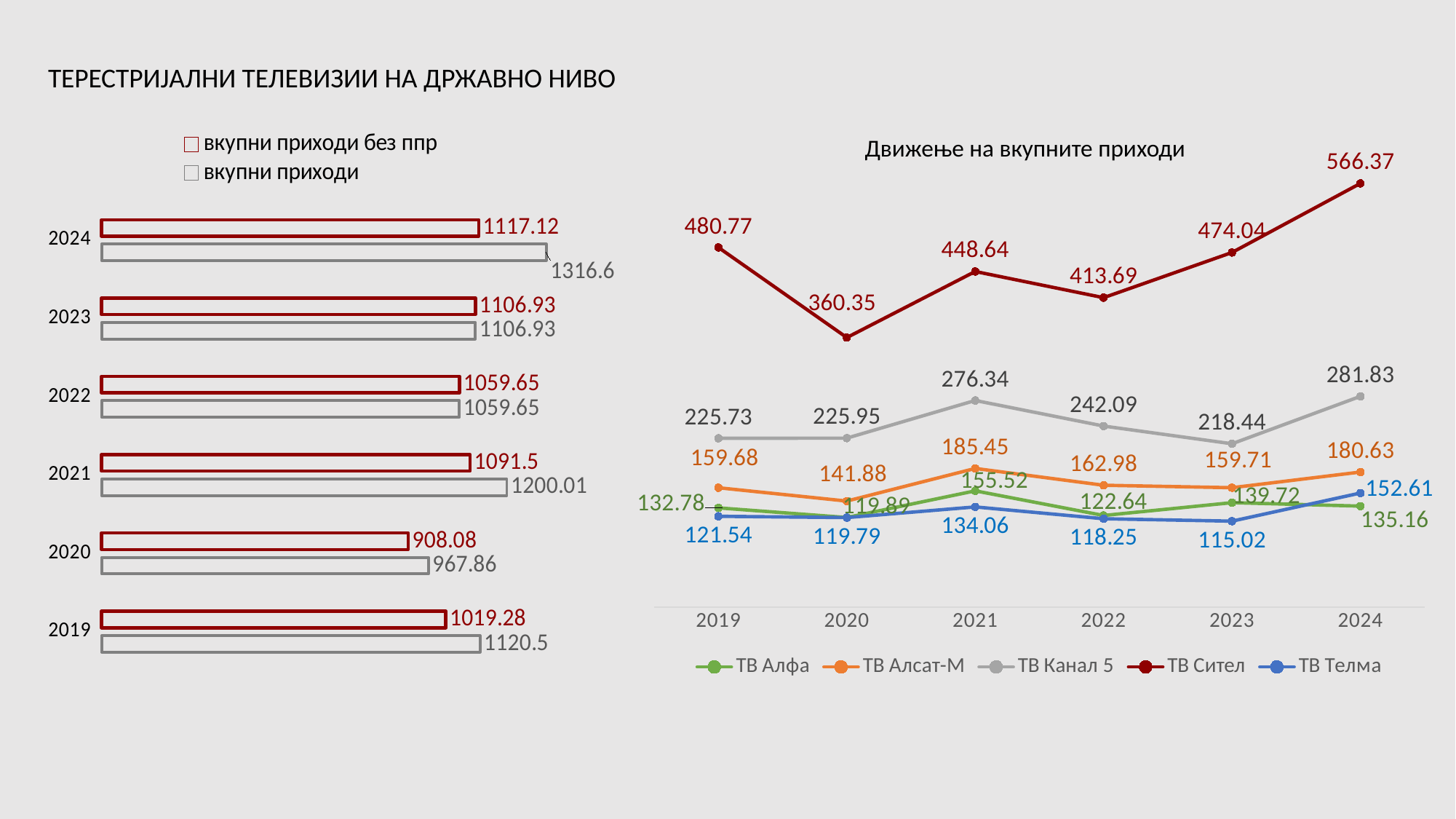
In the chart 'Движење на вкупните приходи', which series has the highest value in 2024? ТВ Сител In the left bar chart, how many series does the legend list? 2 In the left bar chart, which year has the lowest value for 'вкупни приходи'? 2020 In the left bar chart, what is the value of 'вкупни приходи без ппр' for 2020? 908.08 In the left bar chart, what is the difference between 'вкупни приходи' and 'вкупни приходи без ппр' for 2021? 108.51 In the chart 'Движење на вкупните приходи', how many years are shown on the x axis? 6 In the chart 'Движење на вкупните приходи', what is the value for ТВ Сител in 2020? 360.35 In the chart 'Движење на вкупните приходи', which is larger in 2024: ТВ Телма or ТВ Алфа? ТВ Телма In the chart 'Движење на вкупните приходи', what is the difference between ТВ Канал 5 in 2024 and in 2023? 63.39 In the left bar chart, what is the value of 'вкупни приходи' for 2024? 1316.6 What kind of chart is the chart on the left of the slide? bar chart In the chart 'Движење на вкупните приходи', how many series does the legend list? 5